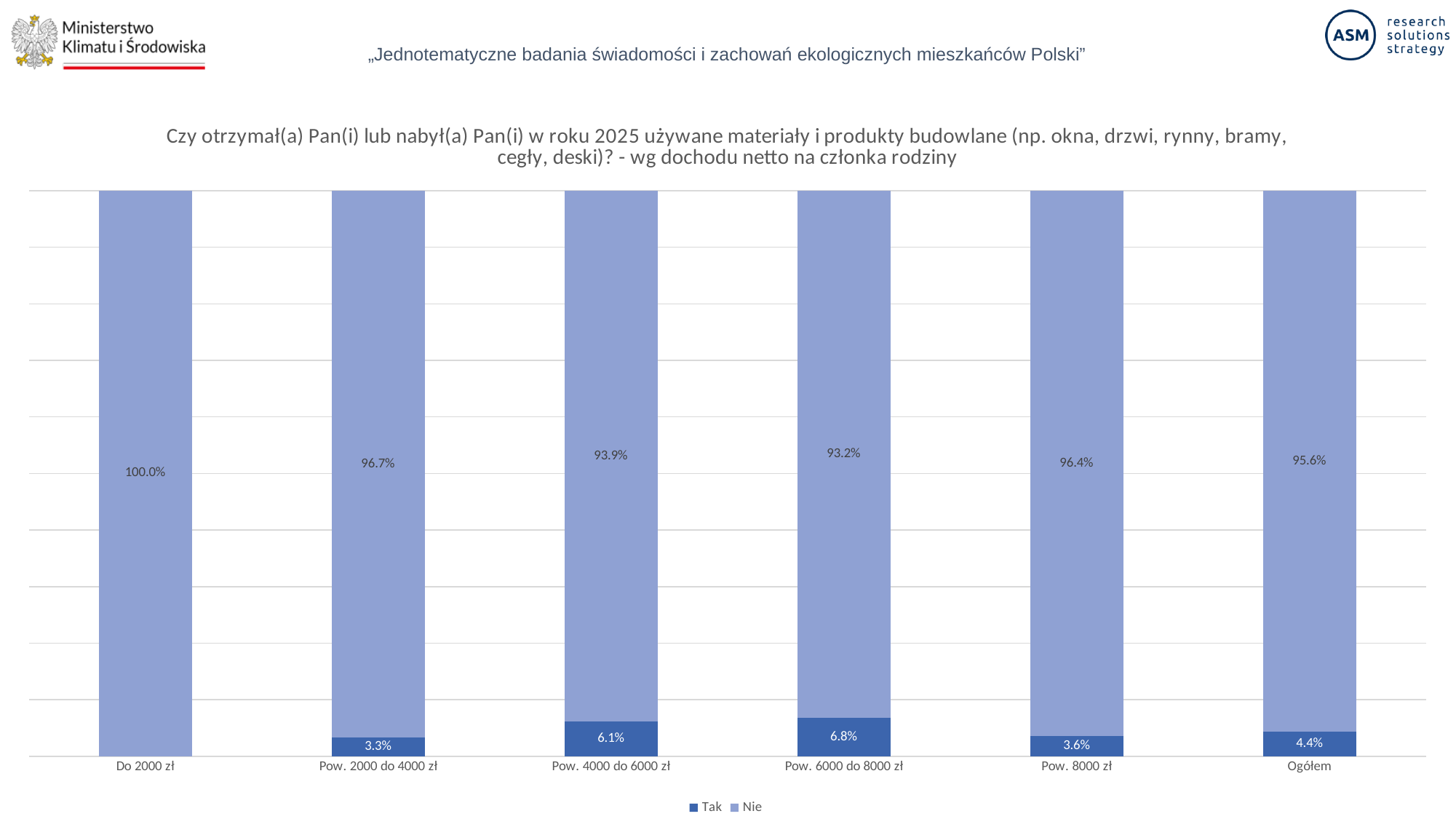
How many series does the legend list? 2 What is the "Tak" value for the "Ogółem" category? 4.4% What is the difference between the "Tak" values for "Pow. 6000 do 8000 zł" and "Pow. 8000 zł"? 3.2% What kind of chart is shown on the slide? Stacked bar chart Which series is shown in the darker blue colour? Tak Which category has the highest "Tak" value? Pow. 6000 do 8000 zł What is the total of the stacked bar for "Pow. 8000 zł"? 100.0% What is the "Nie" value for the "Pow. 4000 do 6000 zł" category? 93.9% Which category has the lowest "Nie" value? Pow. 6000 do 8000 zł How many income categories are shown on the x axis? 6 Which is larger: the "Tak" value for "Pow. 4000 do 6000 zł" or for "Ogółem"? Pow. 4000 do 6000 zł What is the "Tak" value for the "Pow. 2000 do 4000 zł" category? 3.3%